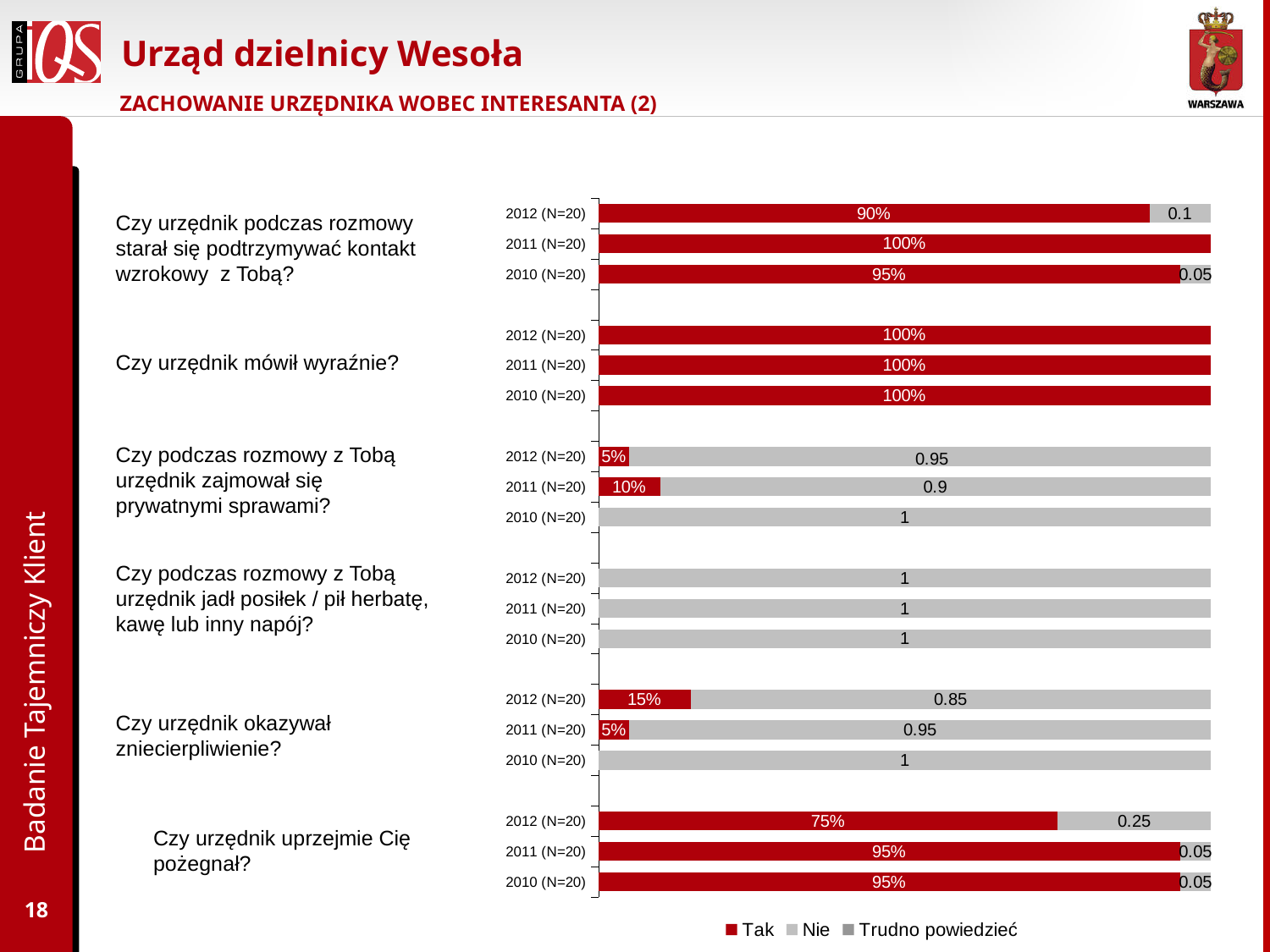
For "Czy urzędnik uprzejmie Cię pożegnał?", which year had the larger "Tak" share, 2012 or 2011? 2011 What kind of chart is shown on the slide? Stacked bar chart For "Czy urzędnik okazywał zniecierpliwienie?", which year had the highest "Tak" share? 2012 (N=20) For "Czy urzędnik uprzejmie Cię pożegnał?", what is the difference between the "Tak" share in 2011 (95%) and in 2012 (75%)? 20% What is the "Nie" value for 2012 (N=20) for "Czy urzędnik okazywał zniecierpliwienie?"? 0.85 What are the legend entries of the chart? Tak, Nie, Trudno powiedzieć What percentage answered "Tak" in 2011 (N=20) for "Czy podczas rozmowy z Tobą urzędnik zajmował się prywatnymi sprawami?"? 10% What percentage answered "Tak" in 2012 (N=20) for "Czy urzędnik uprzejmie Cię pożegnał?"? 75% What percentage answered "Tak" in 2010 (N=20) for "Czy urzędnik mówił wyraźnie?"? 100% What percentage answered "Tak" in 2012 (N=20) for "Czy urzędnik podczas rozmowy starał się podtrzymywać kontakt wzrokowy z Tobą?"? 90% What is the "Nie" value shown for 2012 (N=20) for "Czy urzędnik podczas rozmowy starał się podtrzymywać kontakt wzrokowy z Tobą?"? 0.1 How many series does the legend list? 3